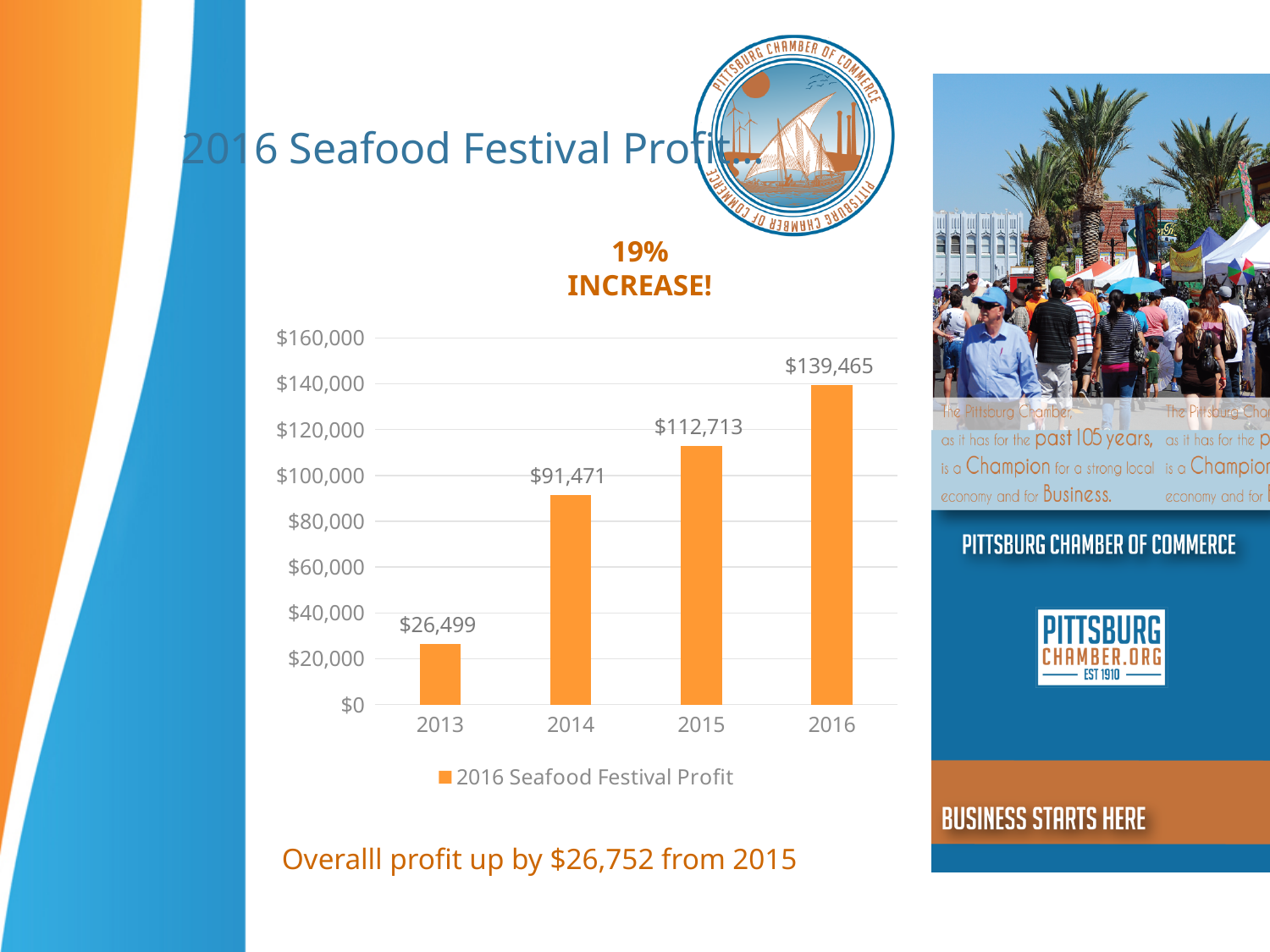
Which year had a larger profit, 2014 or 2015? 2015 What was the Seafood Festival profit in 2013? $26,499 How much higher was the profit in 2014 than in 2013? $64,972 How much higher was the profit in 2016 than in 2015? $26,752 Which year had the lowest Seafood Festival profit? 2013 What type of chart is shown on the slide? Bar chart How many years are shown on the chart? 4 Does the Seafood Festival profit rise or fall from 2013 to 2016? Rise What was the Seafood Festival profit in 2015? $112,713 What was the Seafood Festival profit in 2014? $91,471 Which year had the highest Seafood Festival profit? 2016 What was the Seafood Festival profit in 2016? $139,465